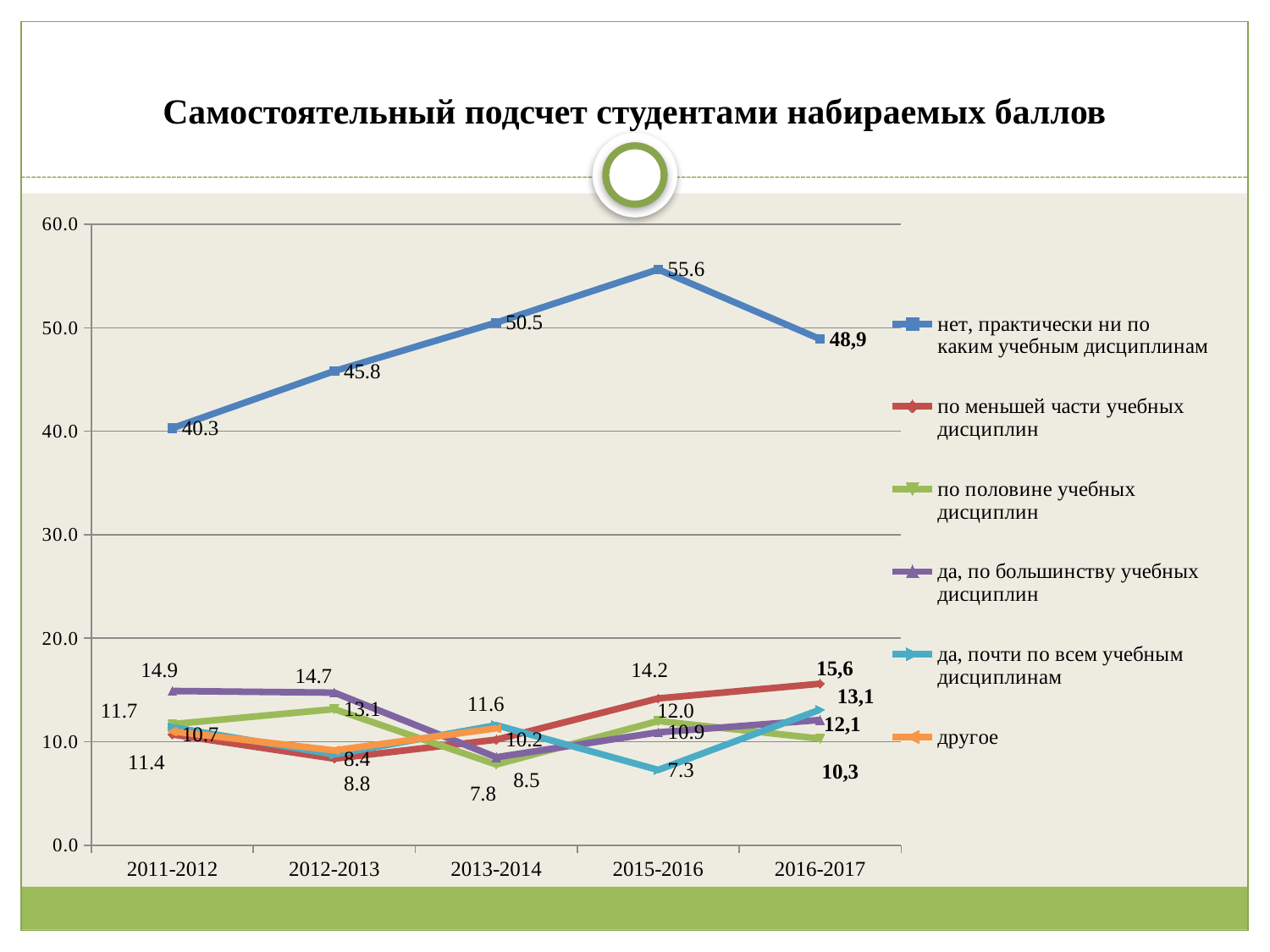
In which year does the series 'нет, практически ни по каким учебным дисциплинам' reach its highest value? 2015-2016 What kind of chart is shown on the slide? line chart How many series does the legend list? 6 How many academic years are shown on the x axis? 5 Which is larger for 'нет, практически ни по каким учебным дисциплинам': the 2012-2013 value or the 2013-2014 value? 2013-2014 What is the value for 'нет, практически ни по каким учебным дисциплинам' in 2011-2012? 40.3 Is the 2016-2017 value for 'нет, практически ни по каким учебным дисциплинам' greater or less than 50.0? less What is the value for 'нет, практически ни по каким учебным дисциплинам' in 2015-2016? 55.6 What is the value for 'нет, практически ни по каким учебным дисциплинам' in 2016-2017? 48,9 What is the difference between the 2015-2016 and 2013-2014 values of 'нет, практически ни по каким учебным дисциплинам'? 5.1 What is the value for 'по меньшей части учебных дисциплин' in 2016-2017? 15,6 In which year is the series 'нет, практически ни по каким учебным дисциплинам' at its lowest? 2011-2012